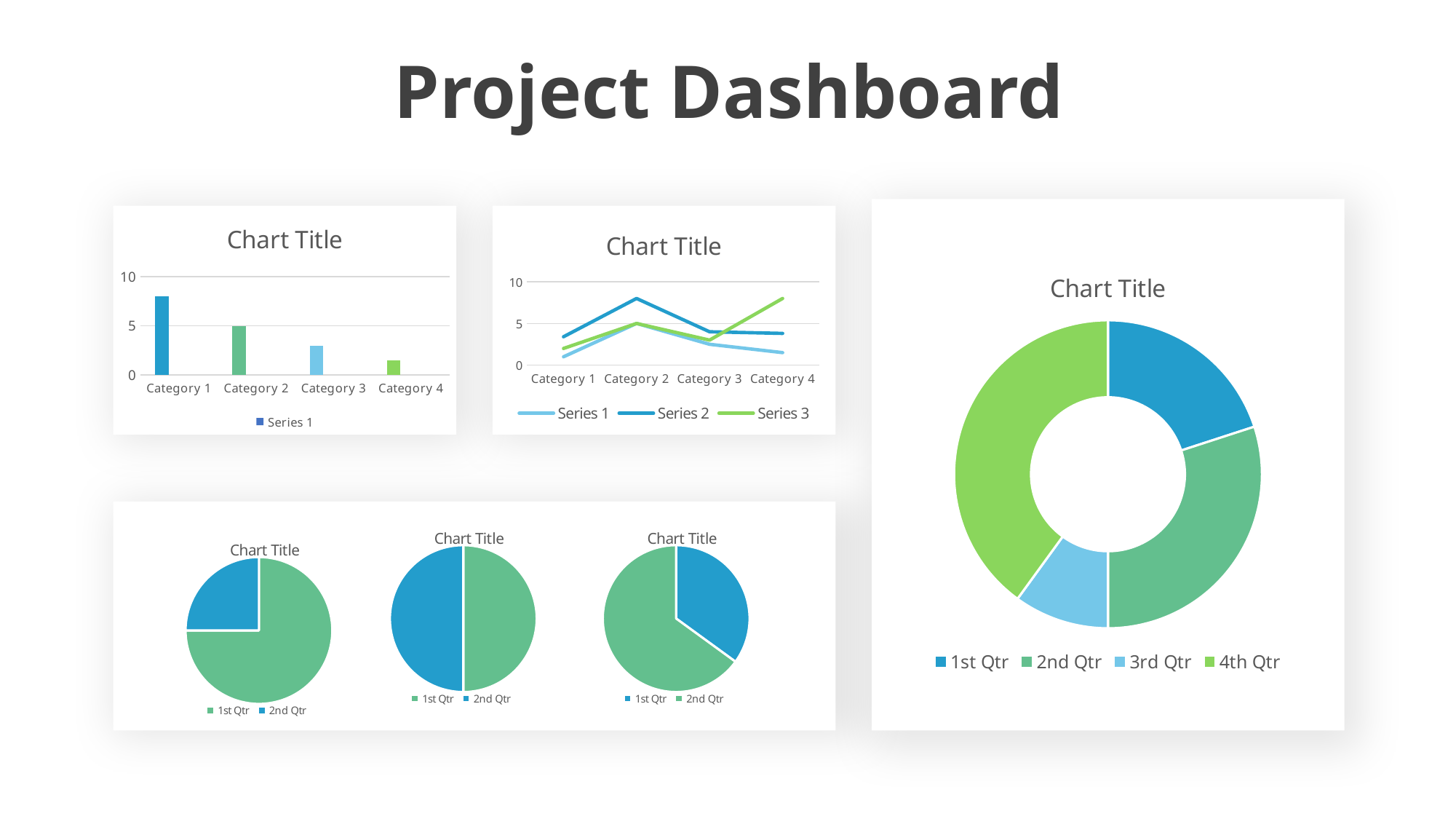
In the top-left bar chart, how many categories are shown on the x axis? 4 In the top-middle line chart, which series has the highest value at Category 4? Series 3 In the leftmost pie chart at the bottom of the slide, which slice is larger, 1st Qtr or 2nd Qtr? 1st Qtr In the top-left bar chart, is the value for Category 3 greater or less than 5? less In the top-left bar chart, is the value for Category 1 greater or less than 5? greater In the doughnut chart on the right, which quarter has the smallest slice? 3rd Qtr In the doughnut chart on the right, which quarter has the largest slice? 4th Qtr In the top-left bar chart, which category has the lowest bar? Category 4 How many series does the legend of the top-middle line chart list? 3 In the top-left bar chart, which category has the highest bar? Category 1 What kind of chart is the top-left chart on the slide? bar chart